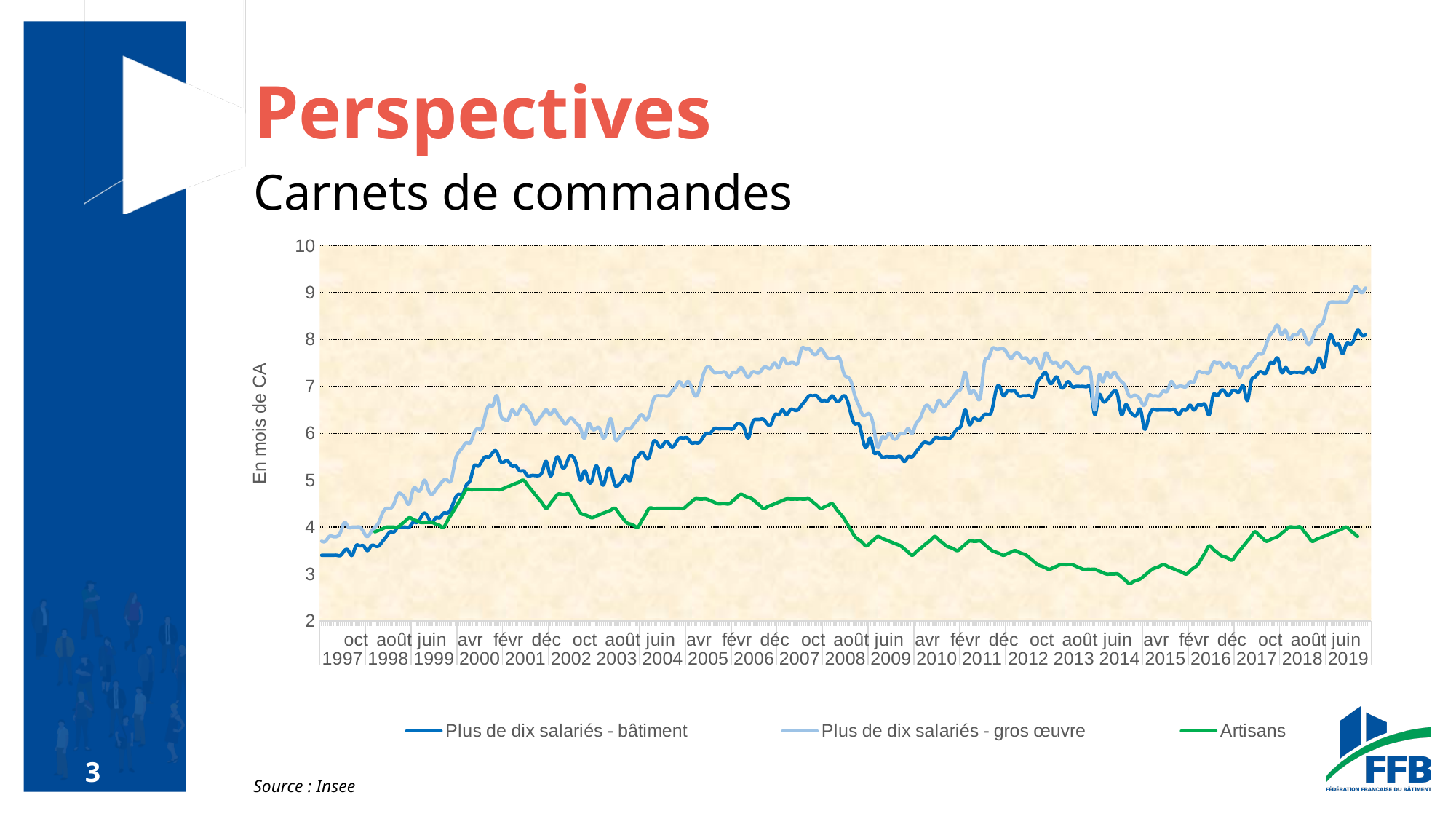
Which series has the highest value at the end of the period, in 2019? Plus de dix salariés - gros œuvre Does the Artisans series rise or fall between 2008 and 2014? fall Does the Plus de dix salariés - gros œuvre series rise or fall between 2016 and 2019? rise Is the value for Plus de dix salariés - gros œuvre in juin 2019 greater or less than 8? greater How many series does the legend list? 3 What is the label on the vertical axis of the chart? En mois de CA What source is cited for the chart? Insee Is the value for Artisans in 2001 greater or less than 4? greater What kind of chart is shown on the slide? line chart Is the value for Plus de dix salariés - bâtiment in juin 2009 greater or less than 6? less